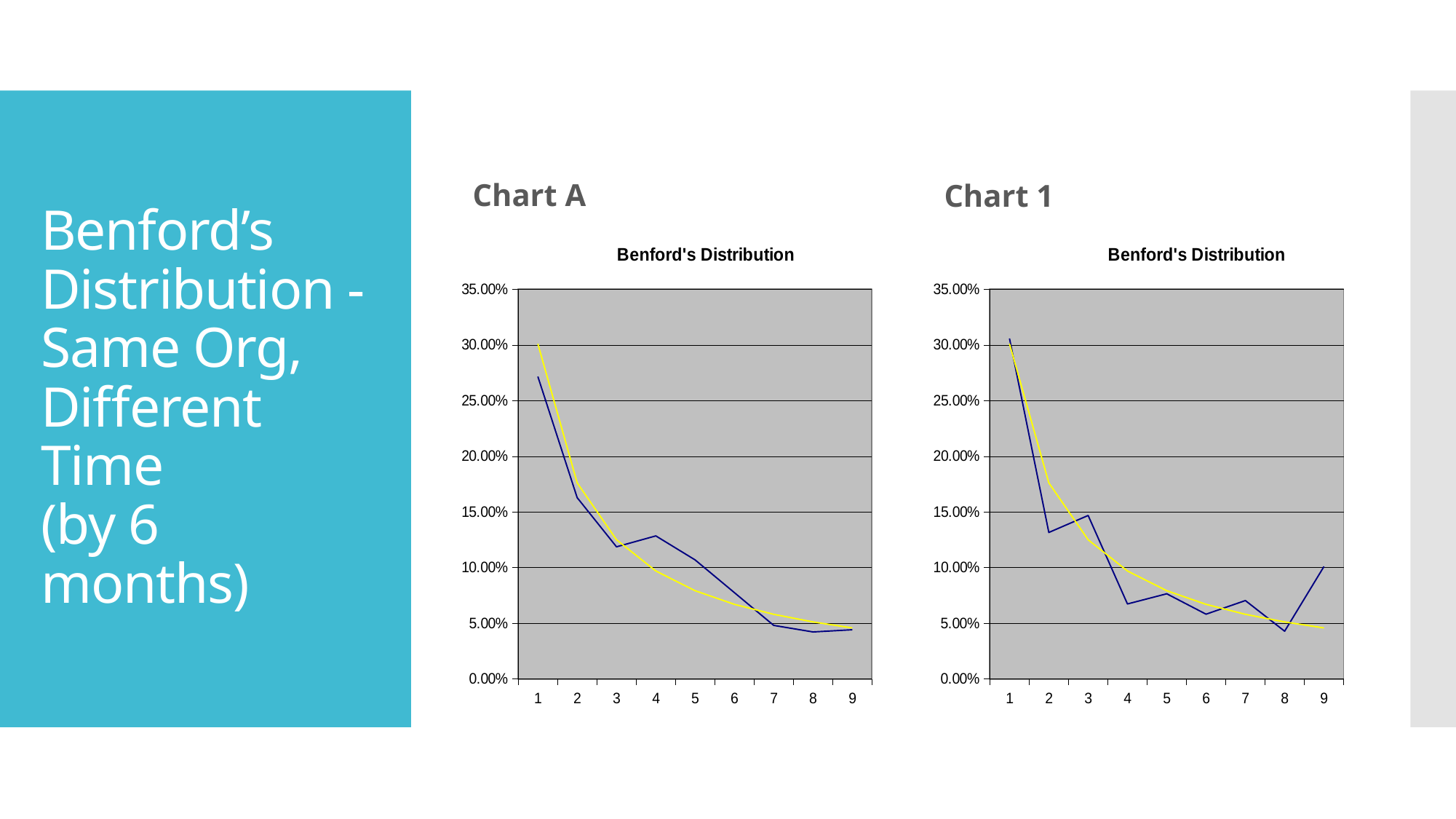
In Chart 1, is the value of the dark blue line at 8 greater or less than 5%? less In Chart A, does the yellow line rise or fall from 1 to 9? fall How many points are plotted along the x axis in Chart 1? 9 In Chart 1, at which x value does the dark blue line reach its lowest point? 8 In Chart A, is the value of the dark blue line at 4 greater or less than 10%? greater In Chart 1, is the value of the dark blue line at 9 greater or less than 5%? greater What is the title printed above the plot area of Chart A? Benford's Distribution In Chart 1, is the dark blue line higher at 8 or at 9? 9 In Chart 1, at which x value does the dark blue line reach its highest point? 1 What kind of chart is Chart A? line chart